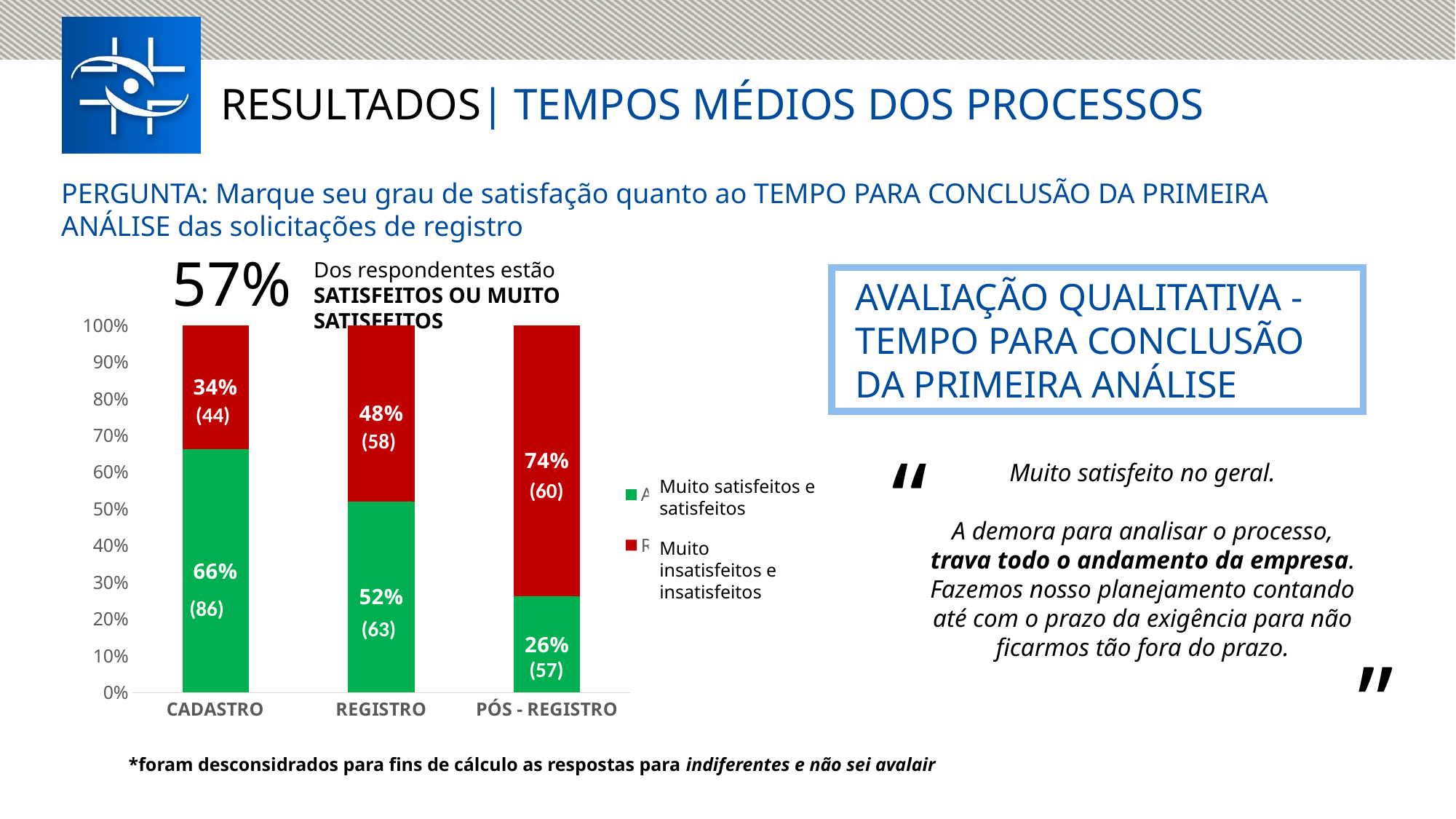
How many categories are shown on the x axis of the chart? 3 What percentage of respondents for PÓS - REGISTRO are 'Muito insatisfeitos e insatisfeitos'? 74% What is the difference in percentage points between the 'Muito insatisfeitos e insatisfeitos' share for PÓS - REGISTRO and for CADASTRO? 40 percentage points Which is larger: the 'Muito satisfeitos e satisfeitos' share for REGISTRO or the 'Muito insatisfeitos e insatisfeitos' share for REGISTRO? Muito satisfeitos e satisfeitos (52%) Does the share of 'Muito satisfeitos e satisfeitos' respondents rise or fall from CADASTRO to PÓS - REGISTRO along the x axis? Fall Which colour represents 'Muito insatisfeitos e insatisfeitos' in the chart? Red What type of chart is shown on the slide? Stacked bar chart Which category has the highest share of 'Muito satisfeitos e satisfeitos' respondents? CADASTRO Which category has the lowest share of 'Muito satisfeitos e satisfeitos' respondents? PÓS - REGISTRO What is the count shown in parentheses for the 'Muito satisfeitos e satisfeitos' segment of REGISTRO? 63 What percentage of respondents for CADASTRO are 'Muito satisfeitos e satisfeitos'? 66% How many series does the chart's legend list? 2